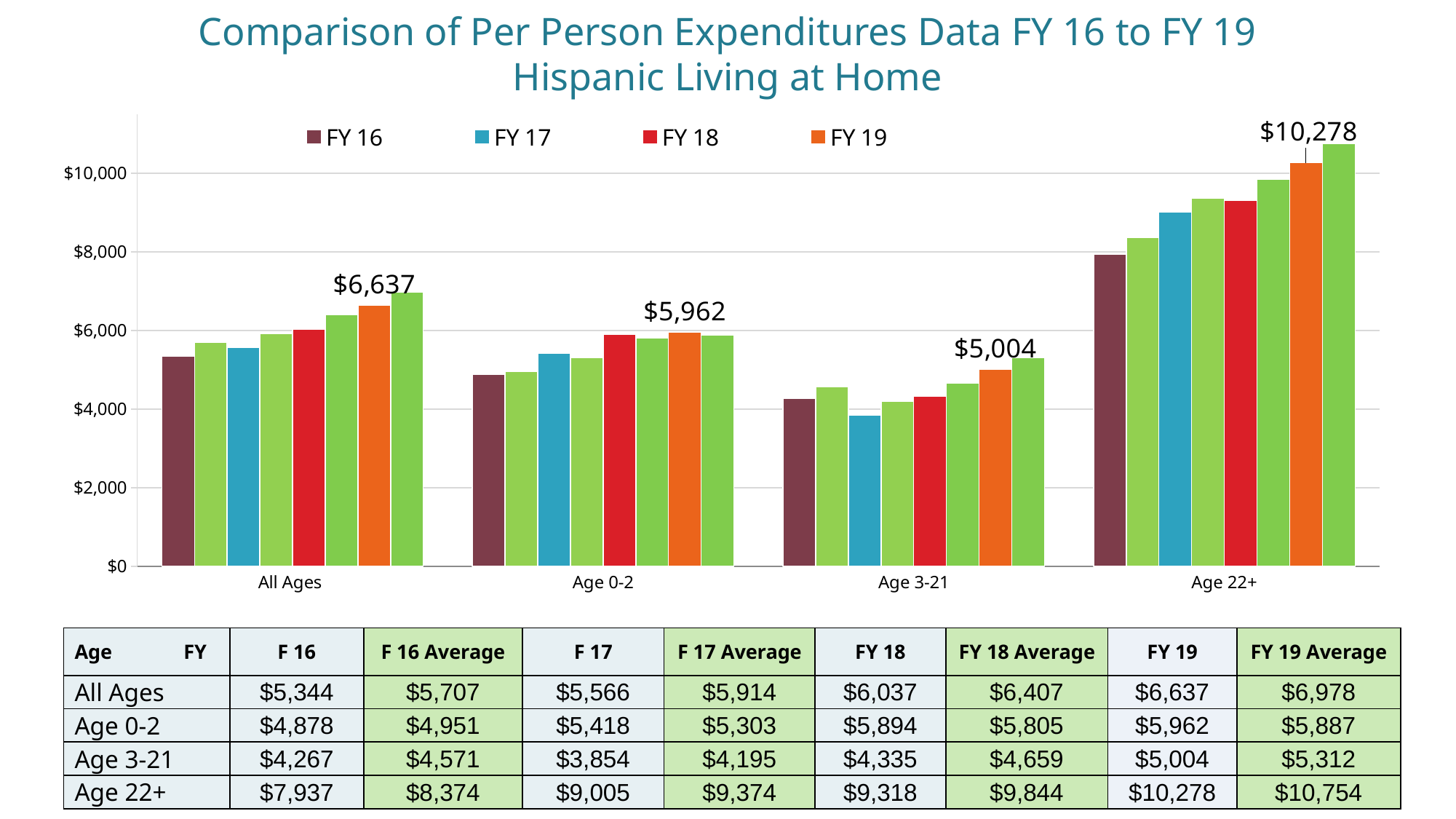
What is the FY 16 per person expenditure for Age 0-2? $4,878 How many age categories are shown along the x axis of the chart? 4 What type of chart is shown on the slide? bar chart What is the FY 19 per person expenditure for Age 22+? $10,278 How many series does the chart legend list? 4 Is the FY 17 expenditure for Age 3-21 greater or less than $4,000? less What is the FY 19 per person expenditure for Age 3-21? $5,004 What is the difference between the FY 19 and FY 16 expenditure for Age 22+? $2,341 Which age category has the lowest FY 19 expenditure? Age 3-21 Do the FY 16 to FY 19 expenditures for All Ages rise or fall over the years? rise What is the FY 19 per person expenditure for All Ages? $6,637 Which age category has the highest FY 19 expenditure? Age 22+